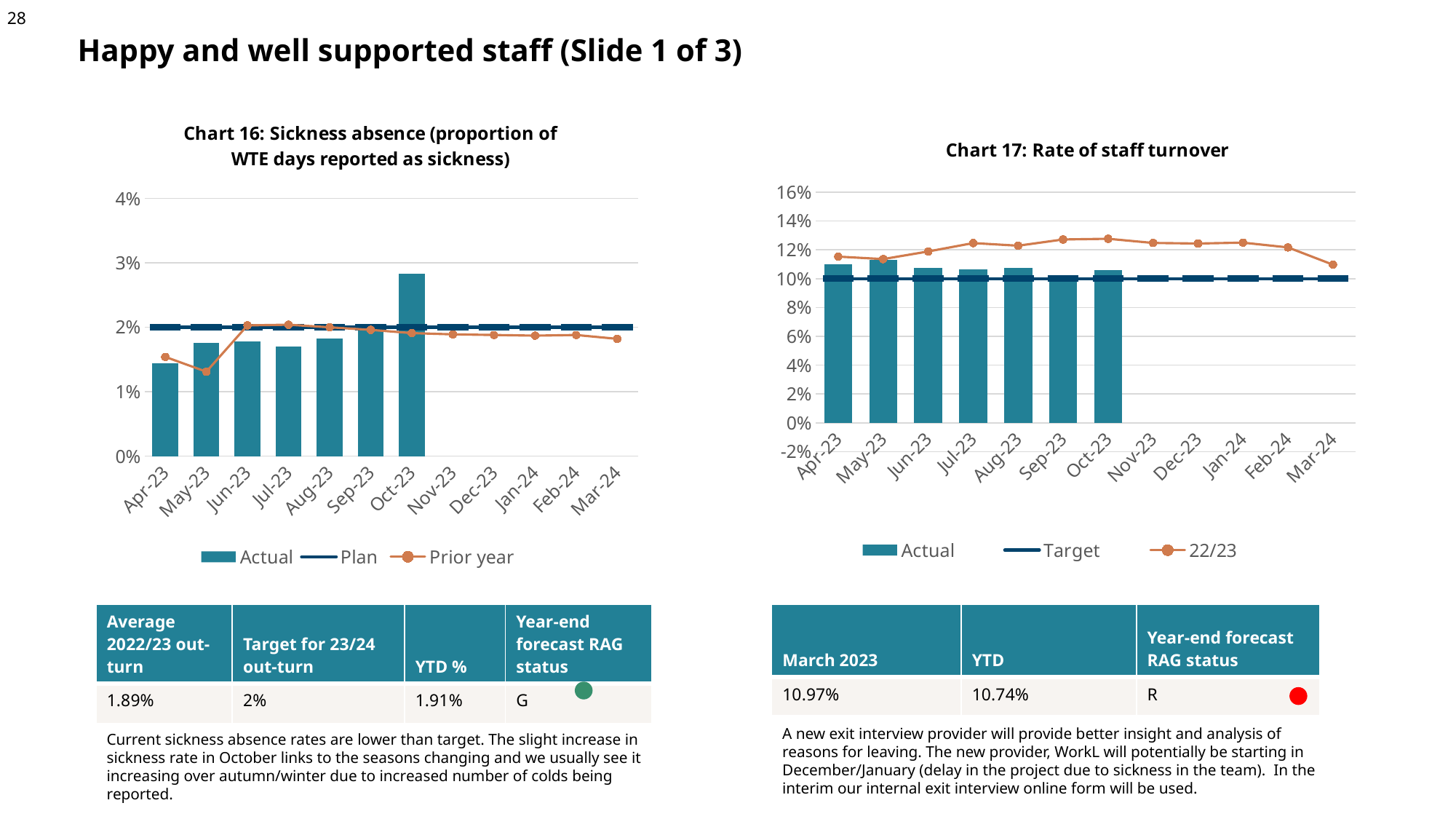
In Chart 17: Rate of staff turnover, which is larger, the Actual bar for Apr-23 or for Sep-23? Apr-23 In Chart 16: Sickness absence, how many months have an Actual bar plotted? 7 In Chart 16: Sickness absence, is the Actual value for Apr-23 greater or less than 2%? less In Chart 17: Rate of staff turnover, which month has the lowest Actual bar? Sep-23 How many series does the legend of Chart 16: Sickness absence list? 3 What are the legend entries in Chart 17: Rate of staff turnover? Actual, Target, 22/23 In Chart 16: Sickness absence, which month has the lowest Actual bar? Apr-23 In Chart 17: Rate of staff turnover, is the Actual value for Apr-23 greater or less than 10%? greater In Chart 16: Sickness absence, which month has the highest Actual bar? Oct-23 In Chart 17: Rate of staff turnover, does the 22/23 line rise or fall from Feb-24 to Mar-24? Fall What type of chart is Chart 16: Sickness absence? Bar chart with line series In Chart 16: Sickness absence, is the Actual value for Oct-23 greater or less than 2%? greater